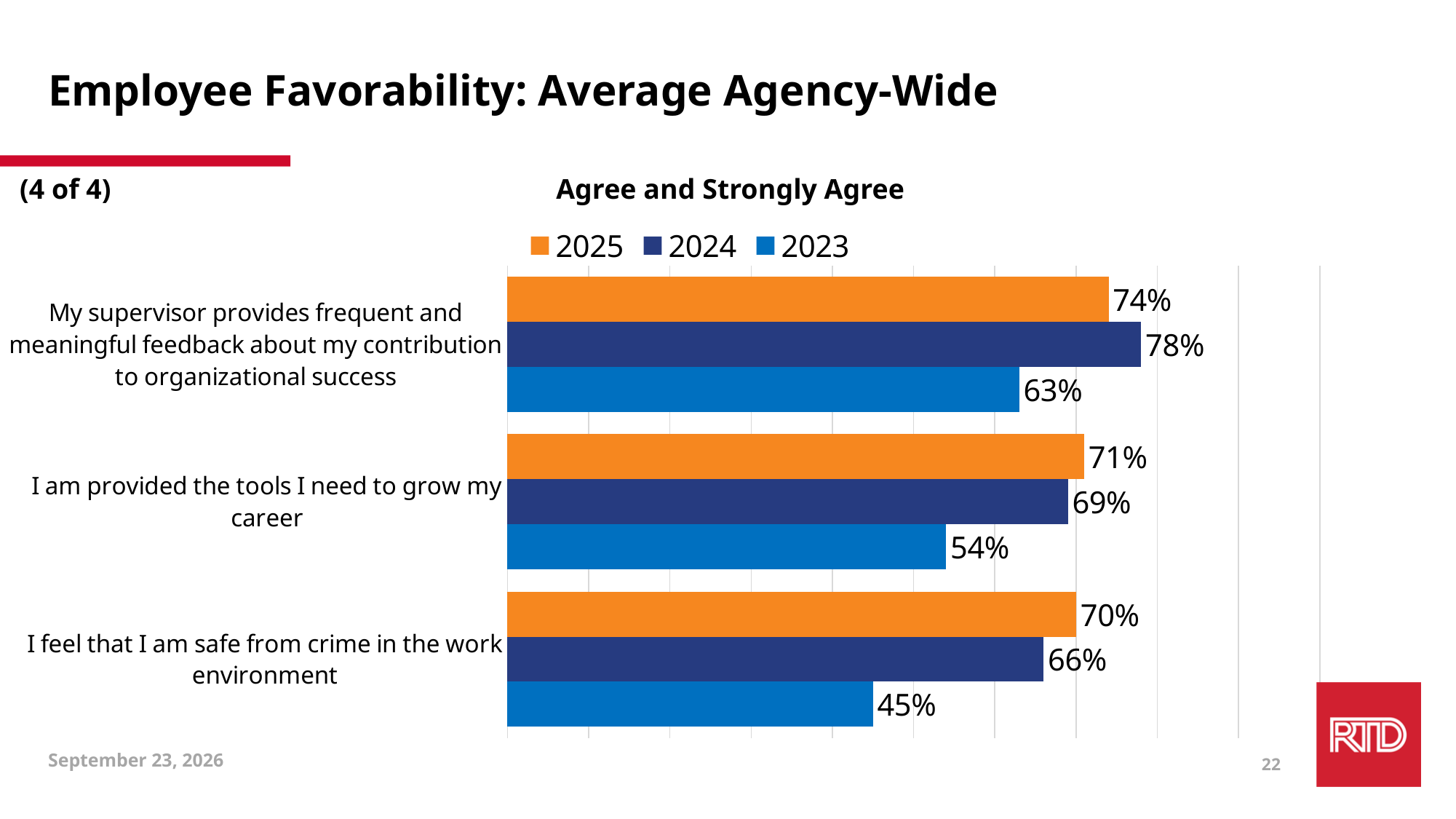
How many series does the legend list? 3 What kind of chart is shown on the slide? Bar chart Which category has the highest 2024 value? My supervisor provides frequent and meaningful feedback about my contribution to organizational success Which category has the lowest 2023 value? I feel that I am safe from crime in the work environment What is the title of the chart? Agree and Strongly Agree What is the 2023 value for "I feel that I am safe from crime in the work environment"? 45% What is the difference between the 2025 and 2023 values for "I feel that I am safe from crime in the work environment"? 25% How many categories are shown on the chart? 3 For "My supervisor provides frequent and meaningful feedback about my contribution to organizational success", which year has the larger value, 2025 or 2024? 2024 What is the 2024 value for "I am provided the tools I need to grow my career"? 69% What is the 2025 value for "My supervisor provides frequent and meaningful feedback about my contribution to organizational success"? 74% Which colour represents the 2025 series in the legend? Orange